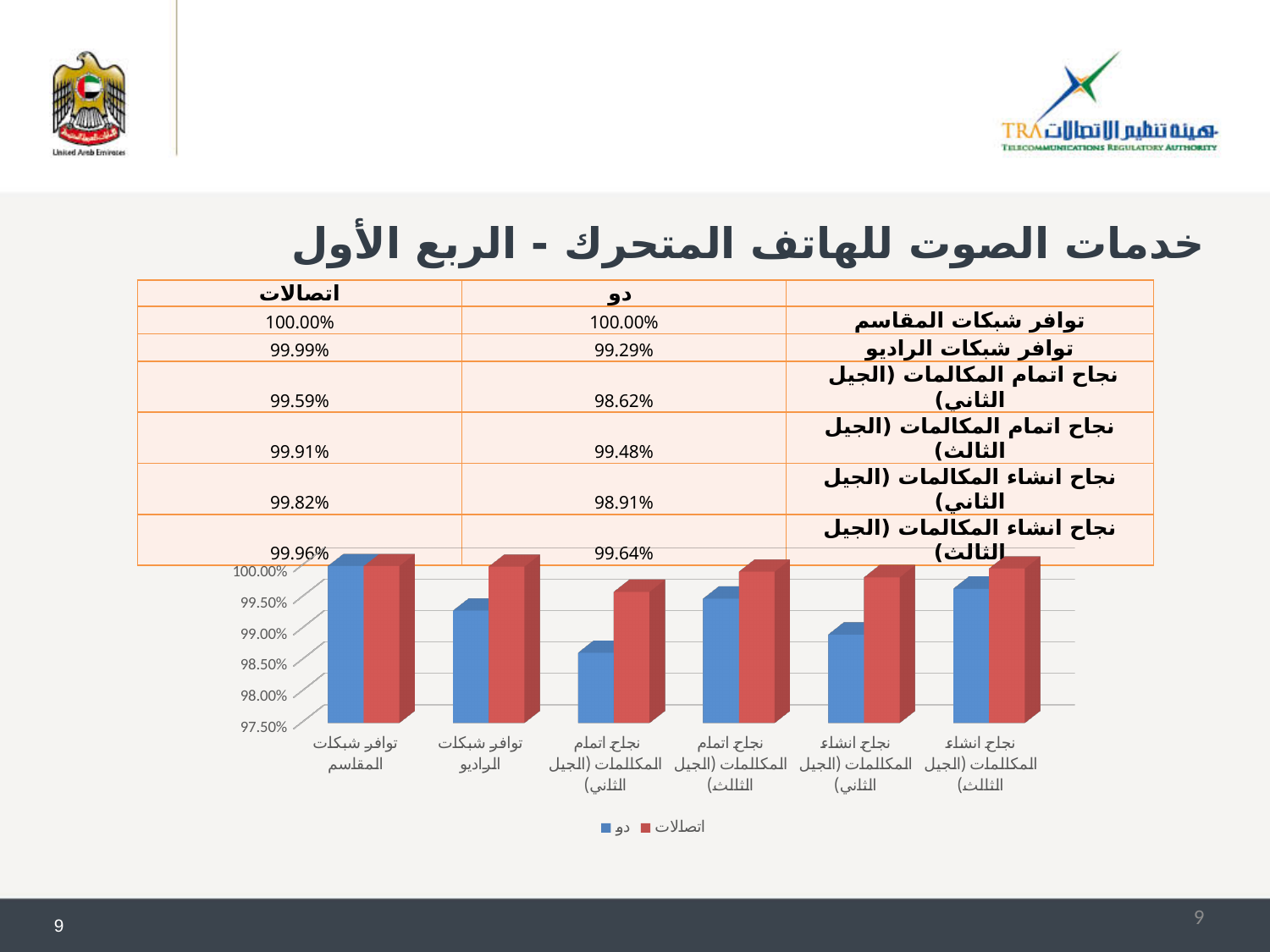
How many categories are shown along the x axis of the chart? 6 What kind of chart is shown on the slide? bar chart For نجاح انشاء المكالمات (الجيل الثاني), which series has the larger value, دو or اتصالات? اتصالات Is the دو value for نجاح اتمام المكالمات (الجيل الثاني) greater or less than 99.00%? less Is the اتصالات value for نجاح اتمام المكالمات (الجيل الثاني) greater or less than 99.00%? greater According to the table above the chart, what is the اتصالات value for نجاح اتمام المكالمات (الجيل الثالث)? 99.91% How many series does the chart legend list? 2 Using the values in the table, what is the difference between اتصالات and دو for نجاح اتمام المكالمات (الجيل الثاني)? 0.97% According to the table above the chart, what is the دو value for توافر شبكات الراديو? 99.29% Which series is drawn in blue in the chart? دو Is the دو value for توافر شبكات الراديو greater or less than 99.00%? greater For which category is the دو bar the lowest? نجاح اتمام المكالمات (الجيل الثاني)